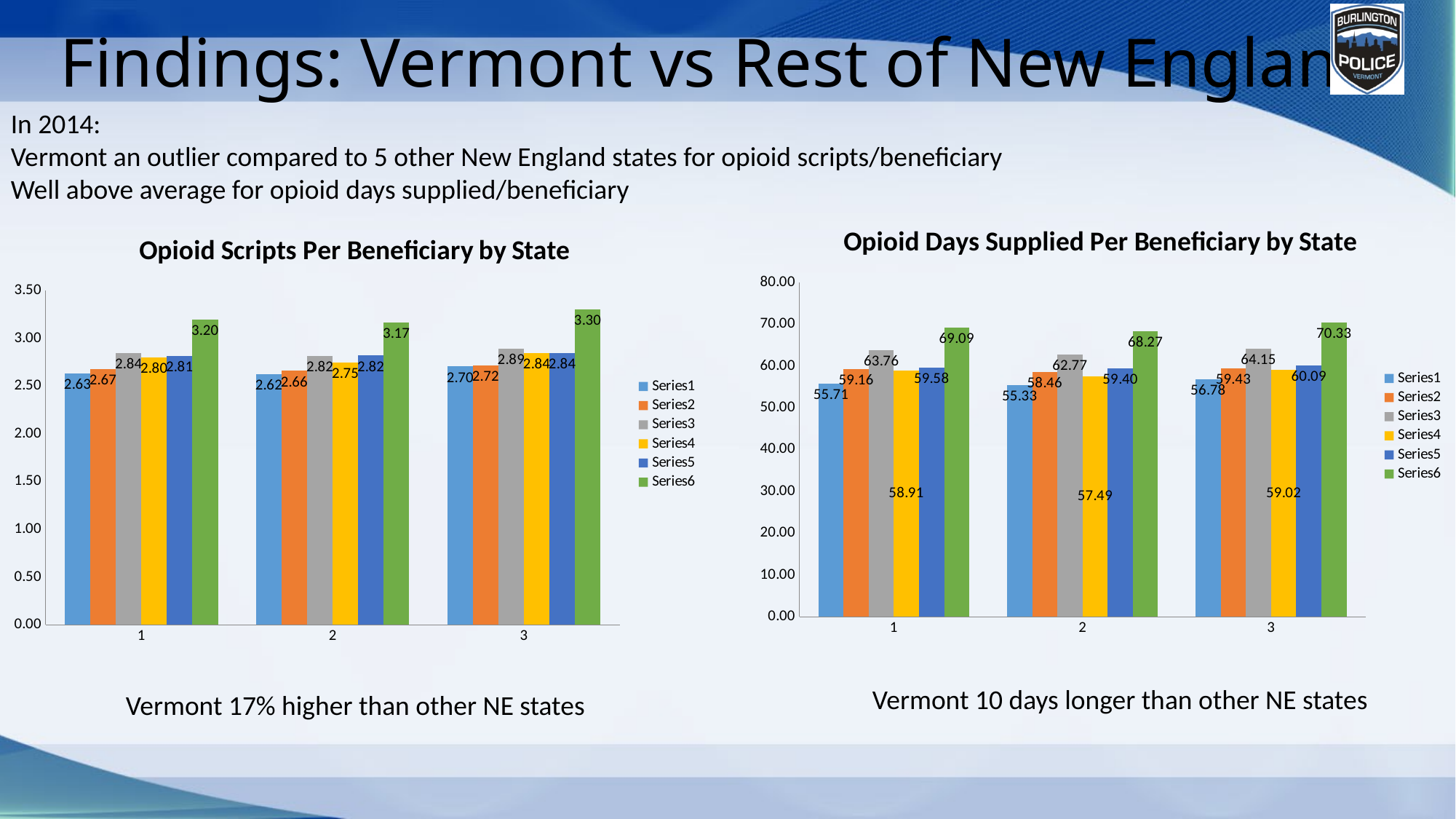
In the 'Opioid Days Supplied Per Beneficiary by State' chart, what is the value for Series3 at category 3? 64.15 How many categories are shown on the x axis of the 'Opioid Scripts Per Beneficiary by State' chart? 3 In the 'Opioid Scripts Per Beneficiary by State' chart, what is the value for Series6 at category 3? 3.30 In the 'Opioid Days Supplied Per Beneficiary by State' chart, what is the value for Series1 at category 2? 55.33 In the 'Opioid Scripts Per Beneficiary by State' chart, what is the difference between Series6 and Series1 at category 1? 0.57 In the 'Opioid Days Supplied Per Beneficiary by State' chart, which is larger at category 3: Series2 or Series5? Series5 In the 'Opioid Scripts Per Beneficiary by State' chart, what is the value for Series1 at category 2? 2.62 How many series does the legend of the 'Opioid Scripts Per Beneficiary by State' chart list? 6 What kind of chart is 'Opioid Days Supplied Per Beneficiary by State'? Bar chart In the 'Opioid Scripts Per Beneficiary by State' chart, which series has the highest value at category 1? Series6 In the 'Opioid Days Supplied Per Beneficiary by State' chart, which series has the lowest value at category 1? Series1 In the 'Opioid Days Supplied Per Beneficiary by State' chart, is the value for Series6 at category 2 greater or less than 60.00? greater